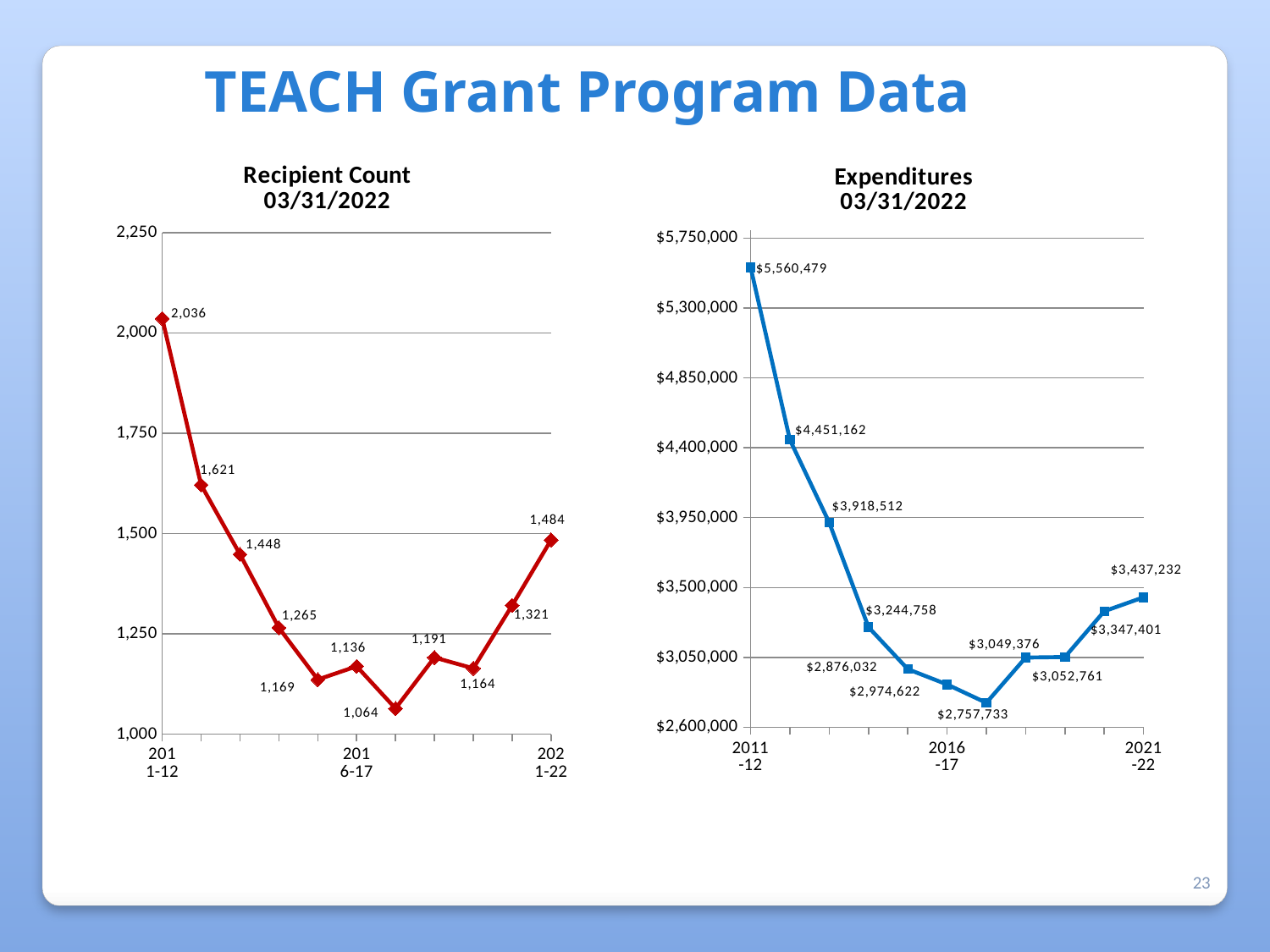
In the Expenditures chart, which is larger: the 2011-12 value or the 2021-22 value? 2011-12 In the Recipient Count chart, what is the recipient count for 2011-12? 2,036 In the Expenditures chart, what is the lowest expenditure value shown? $2,757,733 In the Recipient Count chart, how many data points are plotted? 11 In the Expenditures chart, what is the expenditure for 2011-12? $5,560,479 In the Recipient Count chart, what is the recipient count for 2021-22? 1,484 In the Recipient Count chart, what is the difference between the 2011-12 value and the 2021-22 value? 552 In the Expenditures chart, do the values rise or fall from 2011-12 to 2016-17? fall In the Recipient Count chart, is the value for 2011-12 greater or less than 2,000? greater What type of chart is the Expenditures chart? line chart In the Expenditures chart, what is the expenditure for 2021-22? $3,437,232 In the Recipient Count chart, what is the lowest recipient count shown? 1,064